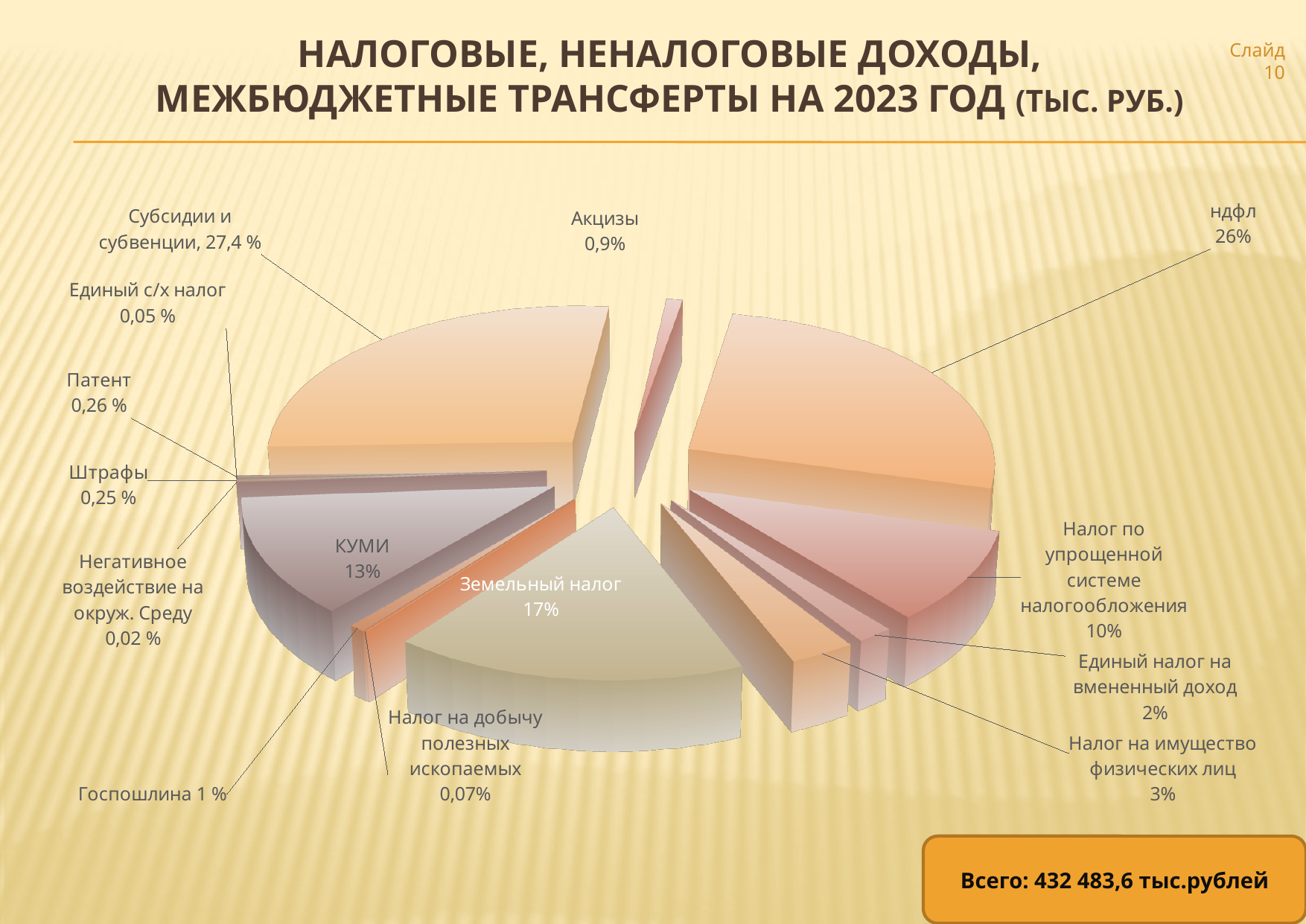
What is the difference in percentage points between "ндфл" and "КУМИ"? 13 What percentage is shown for "Земельный налог"? 17% What is the value shown for "ндфл"? 26% Which category has the smallest share of the pie? Негативное воздействие на окруж. Среду Which is larger: the share for "Налог на имущество физических лиц" or for "Единый налог на вмененный доход"? Налог на имущество физических лиц How many categories are labelled on the pie chart? 14 Which category has the largest share of the pie? Субсидии и субвенции What is the value shown for "Налог по упрощенной системе налогообложения"? 10% What share of the pie does "Субсидии и субвенции" represent? 27,4 % What kind of chart is shown on the slide? Pie chart What total amount is stated in the box at the bottom right of the slide? 432 483,6 тыс.рублей What percentage is shown for "Налог на добычу полезных ископаемых"? 0,07%